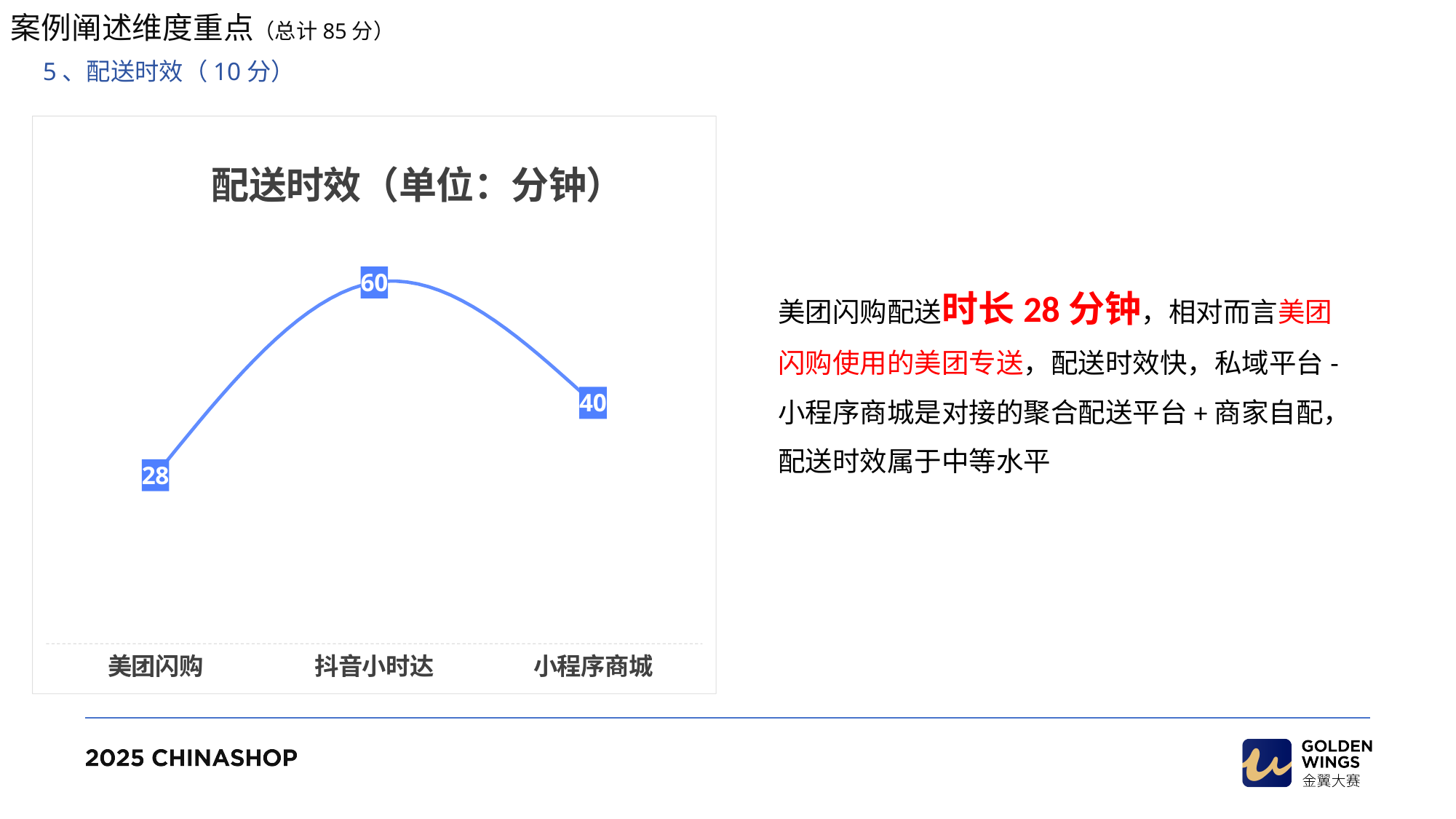
Which has a larger delivery time, 小程序商城 or 美团闪购? 小程序商城 Which category has the highest delivery time? 抖音小时达 What kind of chart is shown on the slide? line chart What is the delivery time value for 美团闪购? 28 What is the delivery time value for 抖音小时达? 60 How many categories are plotted on the chart? 3 What is the difference between the delivery time of 小程序商城 and 美团闪购? 12 What is the delivery time value for 小程序商城? 40 What is the difference between the delivery time of 抖音小时达 and 美团闪购? 32 Do the values rise or fall from 抖音小时达 to 小程序商城? fall What is the title of the chart? 配送时效（单位：分钟） Which category has the lowest delivery time? 美团闪购